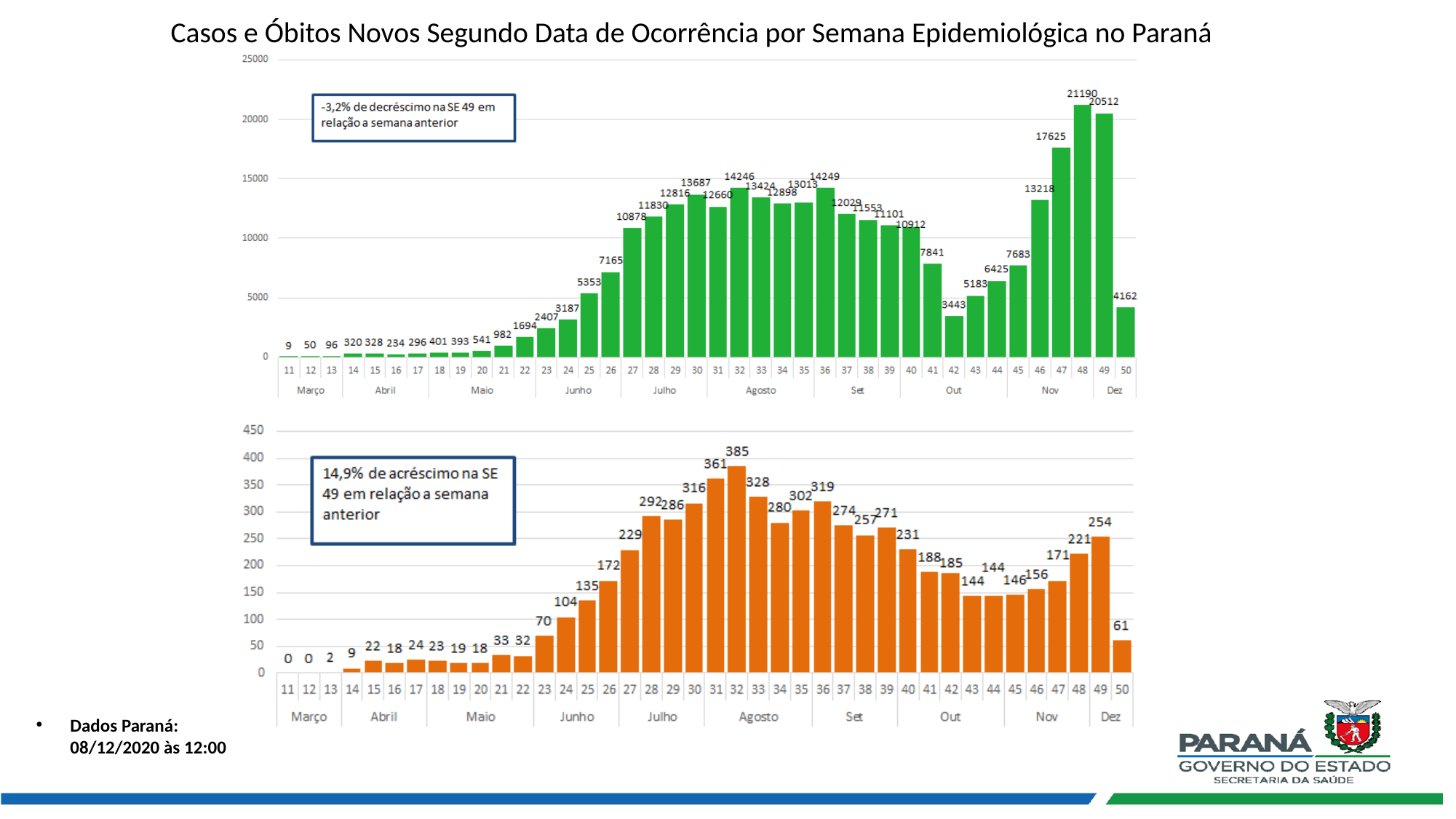
In the bottom (orange) chart, which is larger, week 31 or week 33? week 31 How many weeks are plotted in the bottom (orange) chart? 40 In the bottom (orange) chart, what is the value for week 32? 385 In the top (green) chart, what is the value for week 48? 21190 In the bottom (orange) chart, do the values rise or fall from week 43 to week 49? rise What type of chart is the top chart? bar chart In the bottom (orange) chart, what is the difference between week 49 and week 48? 33 In the top (green) chart, which is larger, week 32 or week 36? week 36 In the top (green) chart, what is the difference between week 48 and week 49? 678 In the top (green) chart, which week has the highest value? 48 In the top (green) chart, what is the value for week 42? 3443 In the bottom (orange) chart, which week has the highest value? 32